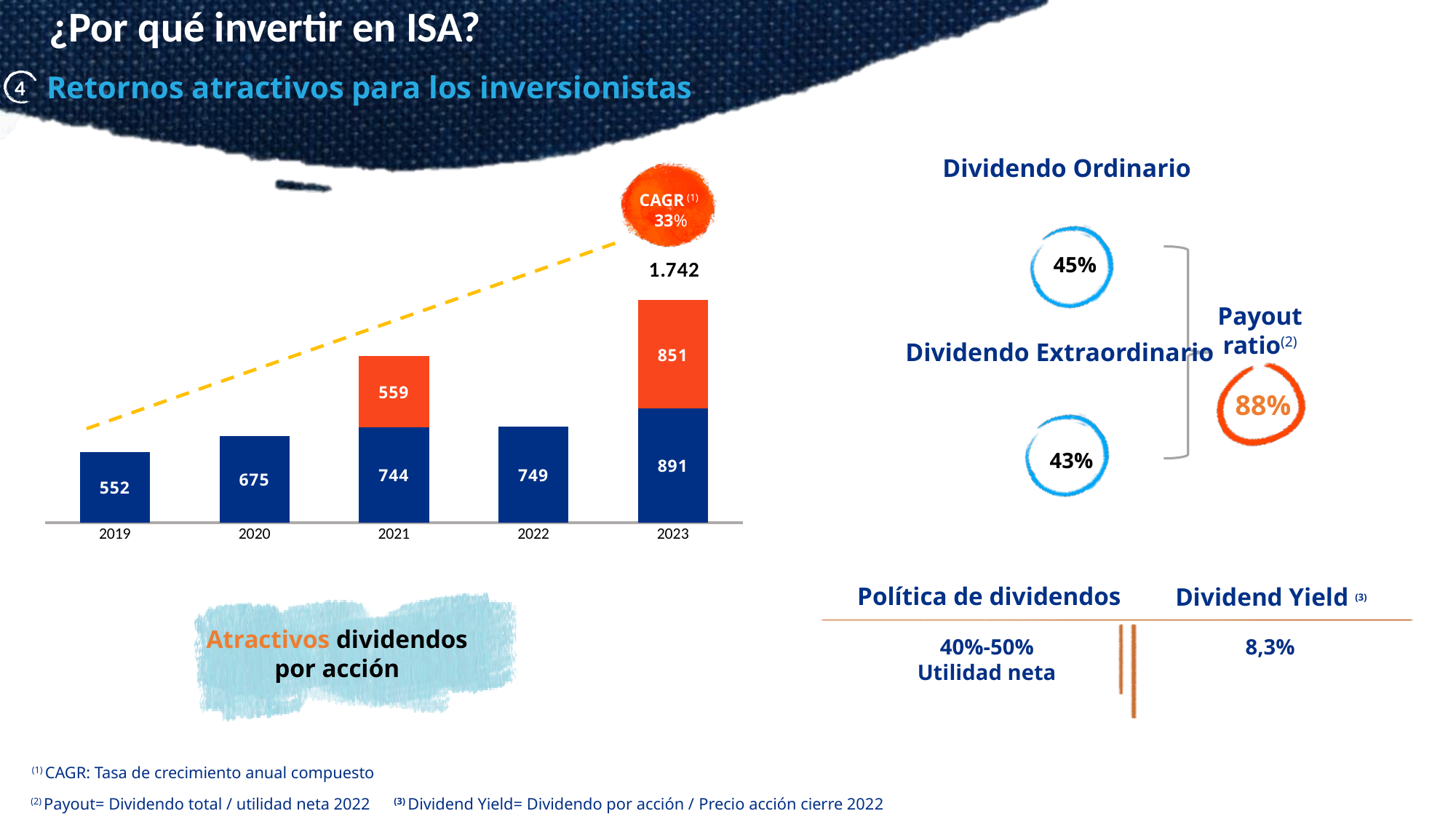
What is the total labelled above the 2023 bar? 1.742 What CAGR value is shown in the orange circle above the bar chart? 33% What is the value of the blue segment for 2019? 552 How many years are shown on the x axis of the bar chart? 5 What is the difference between the blue segment values for 2023 and 2019? 339 Which year has the larger blue segment value, 2021 or 2022? 2022 What is the value of the blue segment for 2023? 891 What is the value of the orange segment for 2021? 559 Which year has the highest blue segment value? 2023 What is the total of the 2021 stacked bar (blue plus orange segments)? 1.303 What kind of chart is used to show the dividends per share by year? Stacked bar chart Which year has the lowest blue segment value? 2019